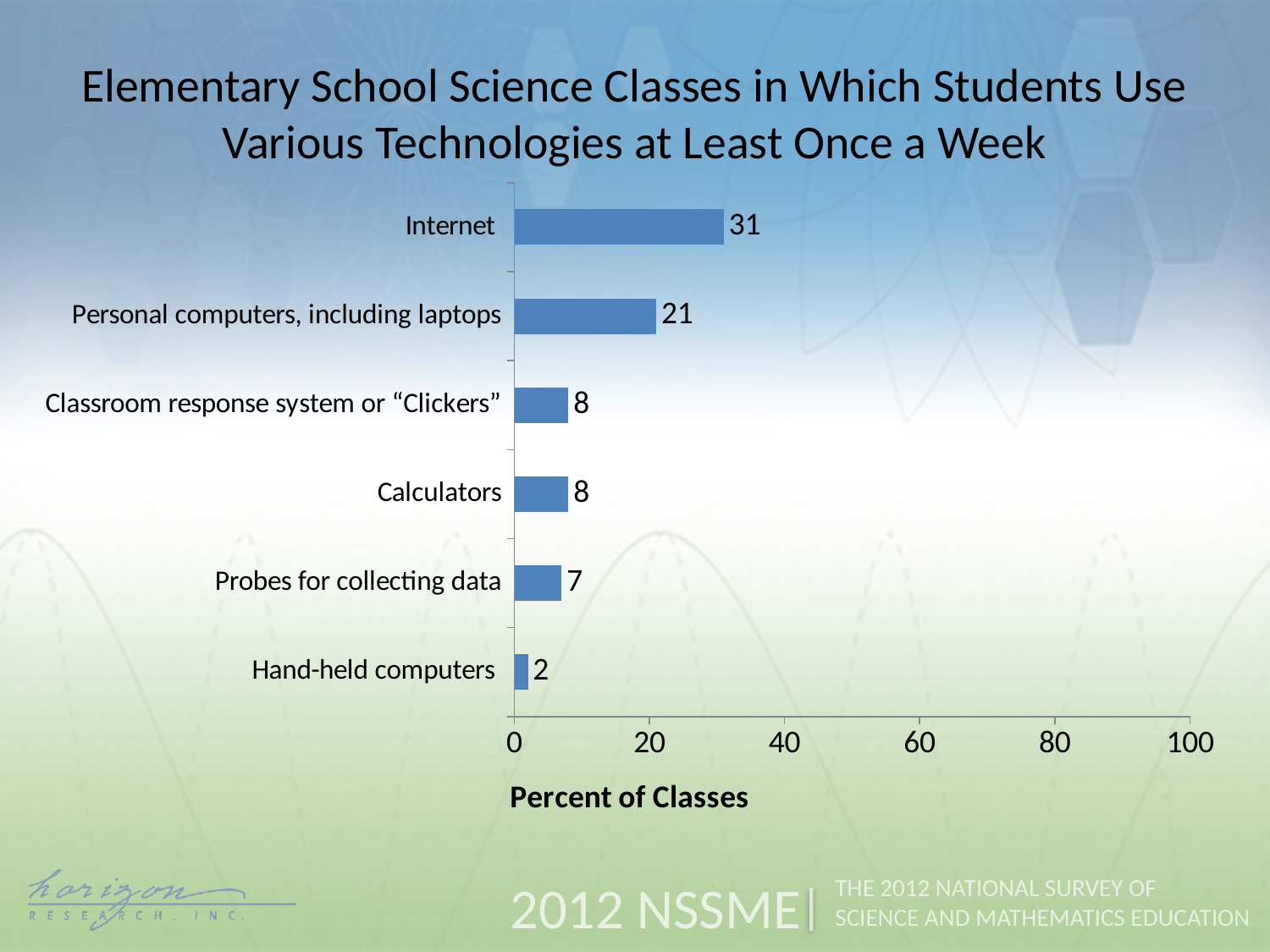
What is the value for Hand-held computers? 2 Is the value for Internet greater or less than 40? less What percent of classes use the Internet at least once a week? 31 What is the value for Personal computers, including laptops? 21 Which technology has the highest percent of classes? Internet How many technology categories are shown in the chart? 6 What is the value for Probes for collecting data? 7 Which technology has the lowest percent of classes? Hand-held computers Which is larger, the value for Calculators or the value for Hand-held computers? Calculators What kind of chart is shown on the slide? Bar chart What is the label of the horizontal axis? Percent of Classes What is the difference between the values for Internet and Personal computers, including laptops? 10